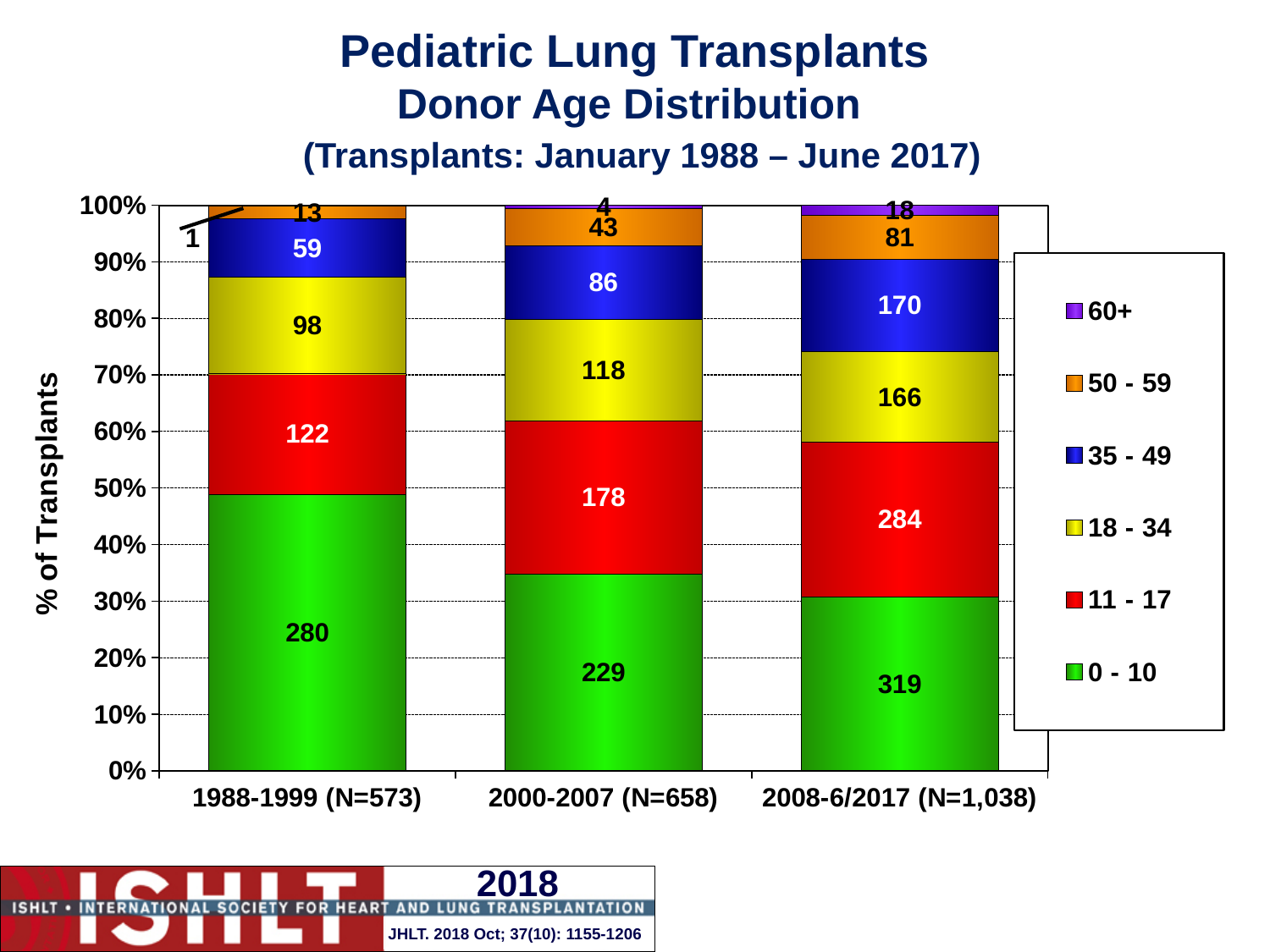
What is the total number of transplants in the 2000-2007 bar? 658 Which is larger: the number of 18 - 34 donors in 2000-2007 or in 1988-1999? 2000-2007 Which era has the smallest number of transplants with donors aged 60+? 1988-1999 How many transplants in 1988-1999 had donors aged 0 - 10? 280 How many transplants in 2000-2007 had donors aged 35 - 49? 86 How many donor age groups does the legend list? 6 Is the share of transplants with donors aged 0 - 10 in 1988-1999 greater or less than 40%? greater What is the difference between the number of 0 - 10 donors in 2008-6/2017 and in 1988-1999? 39 How many transplants in 2008-6/2017 had donors aged 50 - 59? 81 How many transplant eras are shown on the x axis? 3 Which era has the largest number of transplants with donors aged 11 - 17? 2008-6/2017 What kind of chart is shown on the slide? stacked bar chart